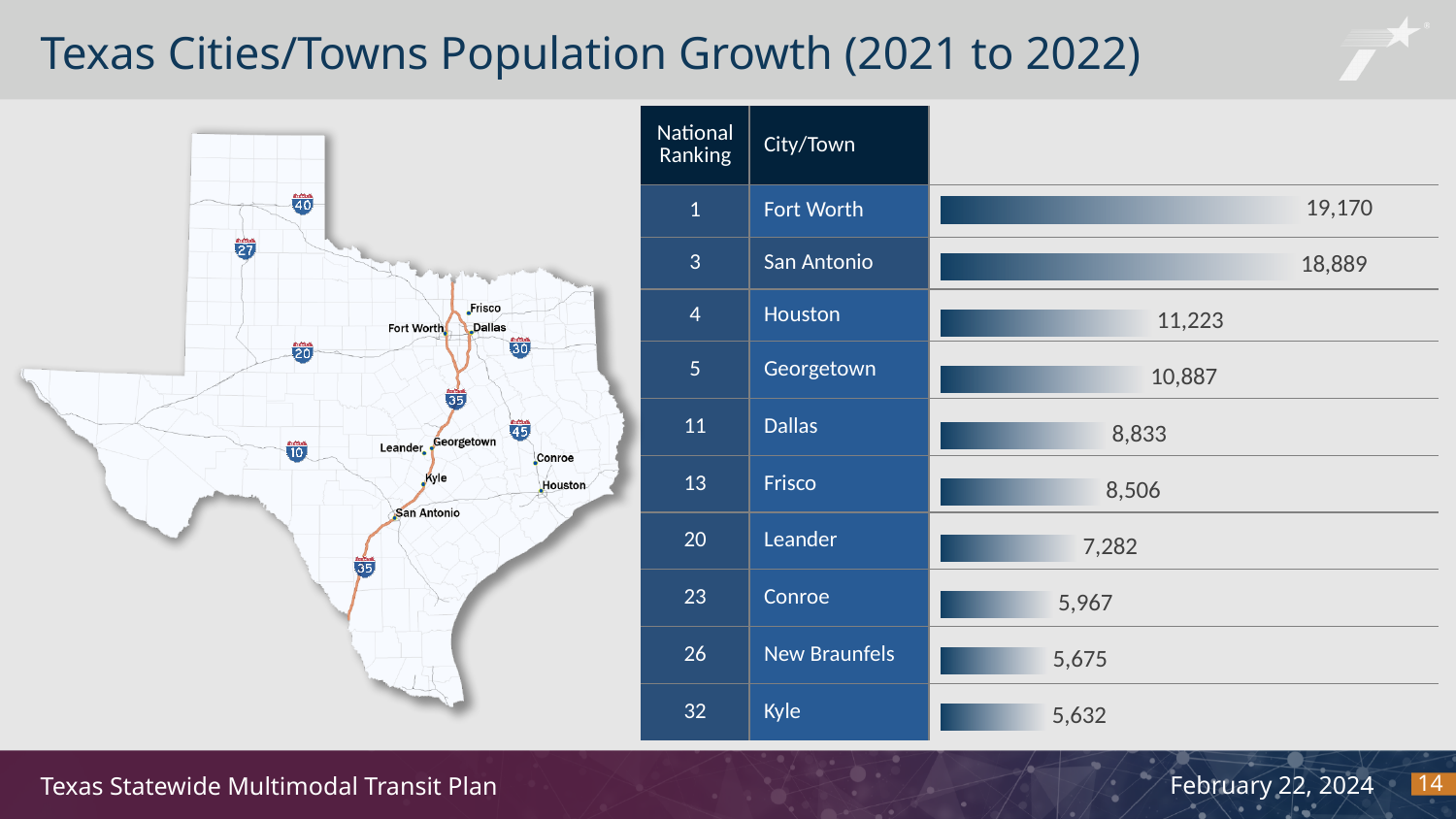
What is the population growth value shown for Georgetown? 10,887 How many cities/towns are shown on the chart? 10 What is the difference between the population growth values for Fort Worth and San Antonio? 281 What kind of chart is used to show the population growth values? Bar chart What is the population growth value shown for Fort Worth? 19,170 Do the population growth values increase or decrease going down the chart from Fort Worth to Kyle? Decrease What is the national ranking listed for Georgetown? 5 What is the population growth value shown for New Braunfels? 5,675 Which has a larger population growth value, Dallas or Leander? Dallas Which city/town has the lowest population growth value on the chart? Kyle What is the difference between the population growth values for Houston and Georgetown? 336 Which city/town has the highest population growth value on the chart? Fort Worth